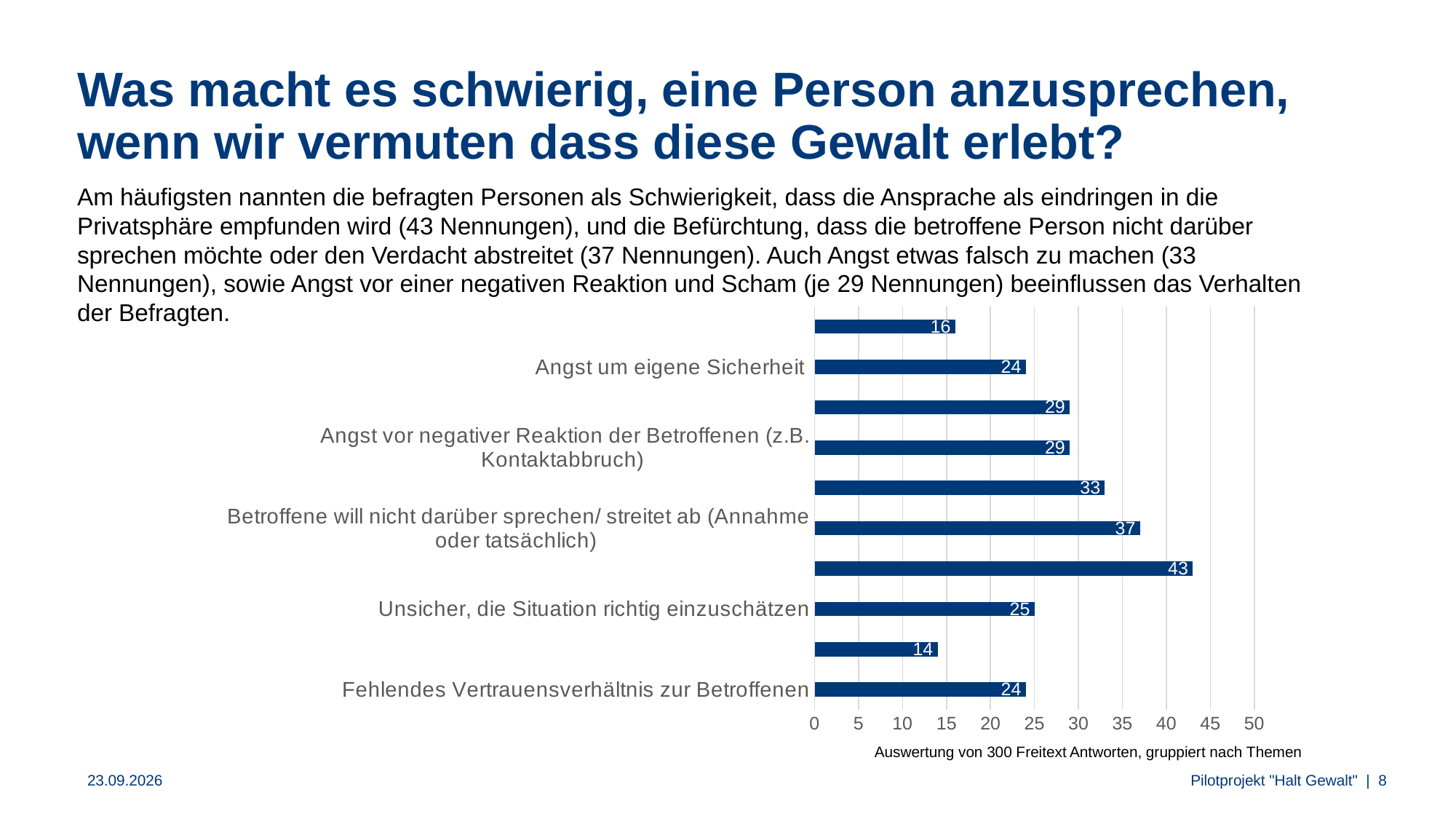
What is the value for "Unsicher, die Situation richtig einzuschätzen"? 25 Which is larger: the value for "Unsicher, die Situation richtig einzuschätzen" or the value for "Angst vor negativer Reaktion der Betroffenen"? Angst vor negativer Reaktion der Betroffenen What is the value for "Betroffene will nicht darüber sprechen/ streitet ab (Annahme oder tatsächlich)"? 37 What is the highest tick value shown on the chart's value axis? 50 What is the value for "Angst vor negativer Reaktion der Betroffenen (z.B. Kontaktabbruch)"? 29 What kind of chart is shown on the slide? Bar chart What is the value for "Angst um eigene Sicherheit"? 24 What is the lowest value shown by any bar in the chart? 14 What is the highest value shown by any bar in the chart? 43 What is the difference between the values for "Betroffene will nicht darüber sprechen/ streitet ab" and "Angst um eigene Sicherheit"? 13 How many bars are plotted in the chart? 10 What is the value for "Fehlendes Vertrauensverhältnis zur Betroffenen"? 24